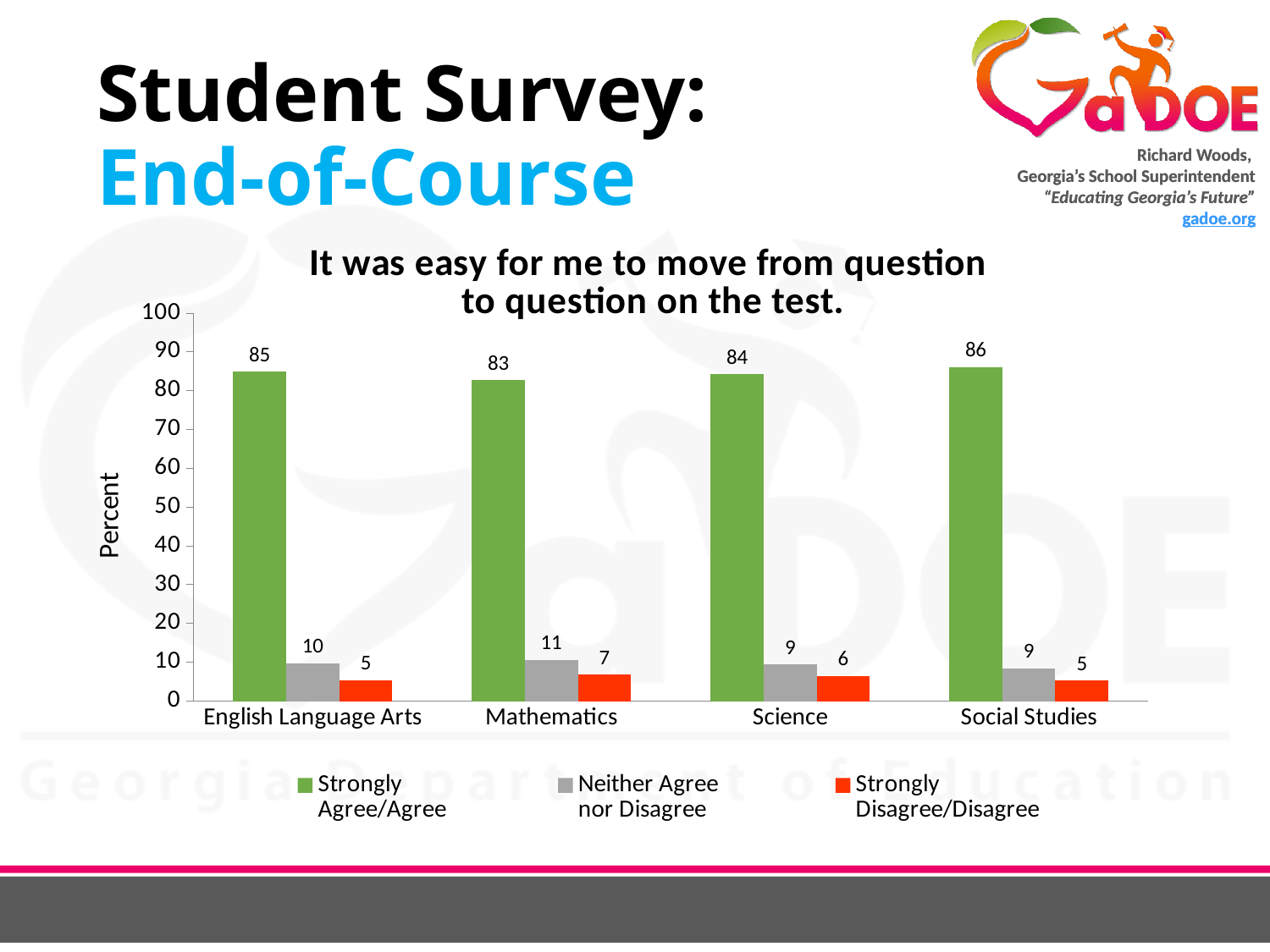
How many subjects are shown on the x axis? 4 Which is larger, the Neither Agree nor Disagree value for Mathematics or for Science? Mathematics Which subject has the highest Strongly Agree/Agree value? Social Studies Is the Strongly Agree/Agree value for Science greater or less than 80? greater How many series does the legend list? 3 What is the Strongly Disagree/Disagree value for Science? 6 What kind of chart is shown on the slide? bar chart What is the difference between the Strongly Agree/Agree values for Social Studies and Mathematics? 3 What is the Strongly Agree/Agree value for Mathematics? 83 What is the Neither Agree nor Disagree value for English Language Arts? 10 Which subject has the lowest Strongly Agree/Agree value? Mathematics What is the label on the vertical axis? Percent